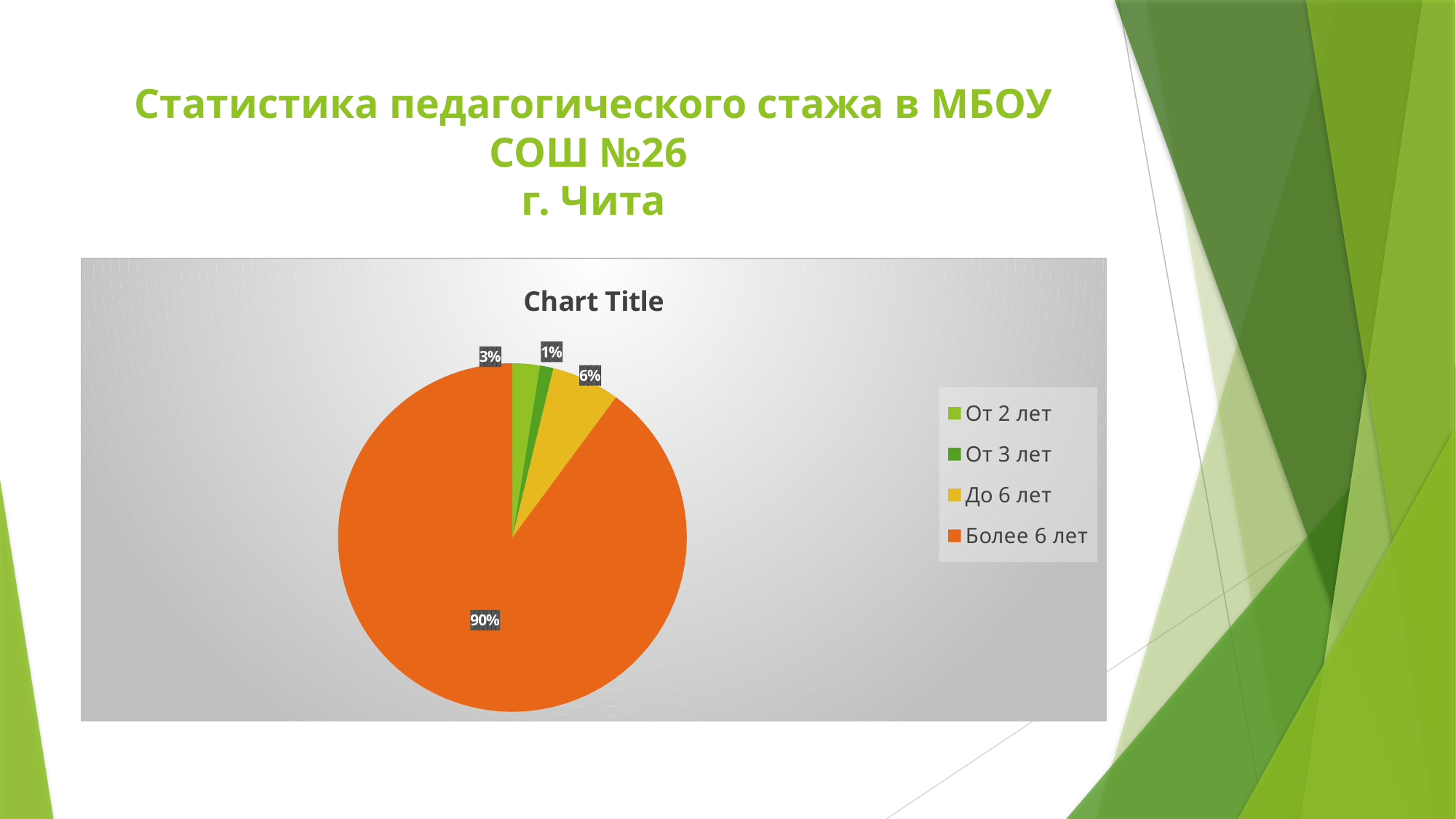
What share of the pie does "До 6 лет" take? 6% What is the title printed above the pie chart? Chart Title What is the difference in percentage points between "Более 6 лет" and "До 6 лет"? 84 How many categories does the pie chart show? 4 Which is larger, the slice for "До 6 лет" or the slice for "От 2 лет"? До 6 лет What colour is the slice for "Более 6 лет"? orange Which category has the largest slice of the pie? Более 6 лет What share of the pie does "От 3 лет" take? 1% What kind of chart is shown on the slide? pie chart What share of the pie does "От 2 лет" take? 3% Which category has the smallest slice of the pie? От 3 лет